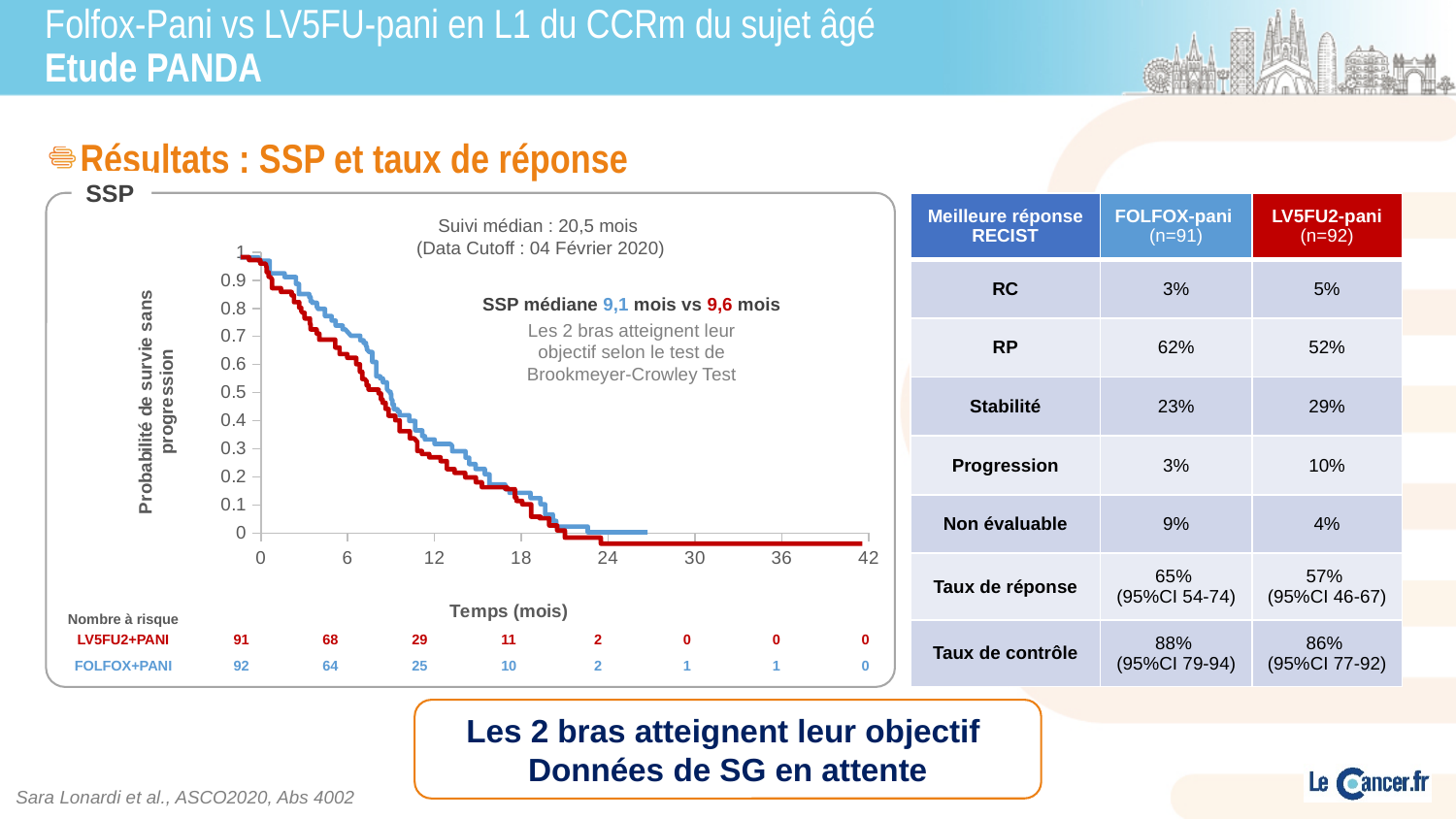
What is the label of the x axis of the SSP chart? Temps (mois) On the SSP chart, is the progression-free survival probability at 12 months greater or less than 0.5 for both arms? less How many treatment arms (series) are plotted on the SSP chart? 2 On the SSP chart, which arm has more patients at risk at 6 months, LV5FU2+PANI or FOLFOX+PANI? LV5FU2+PANI What kind of chart is the SSP chart on the slide? line chart On the SSP chart, what is the number at risk for LV5FU2+PANI at 12 months? 29 On the SSP chart, what is the number at risk for LV5FU2+PANI at time 0? 91 According to the SSP chart annotation, what is the median SSP for the FOLFOX+PANI arm? 9,1 mois On the SSP chart, what is the difference between the numbers at risk at time 0 for FOLFOX+PANI and LV5FU2+PANI? 1 On the SSP chart, what is the number at risk for FOLFOX+PANI at 6 months? 64 Do the survival curves on the SSP chart rise or fall as time increases? fall What is the label of the y axis of the SSP chart? Probabilité de survie sans progression